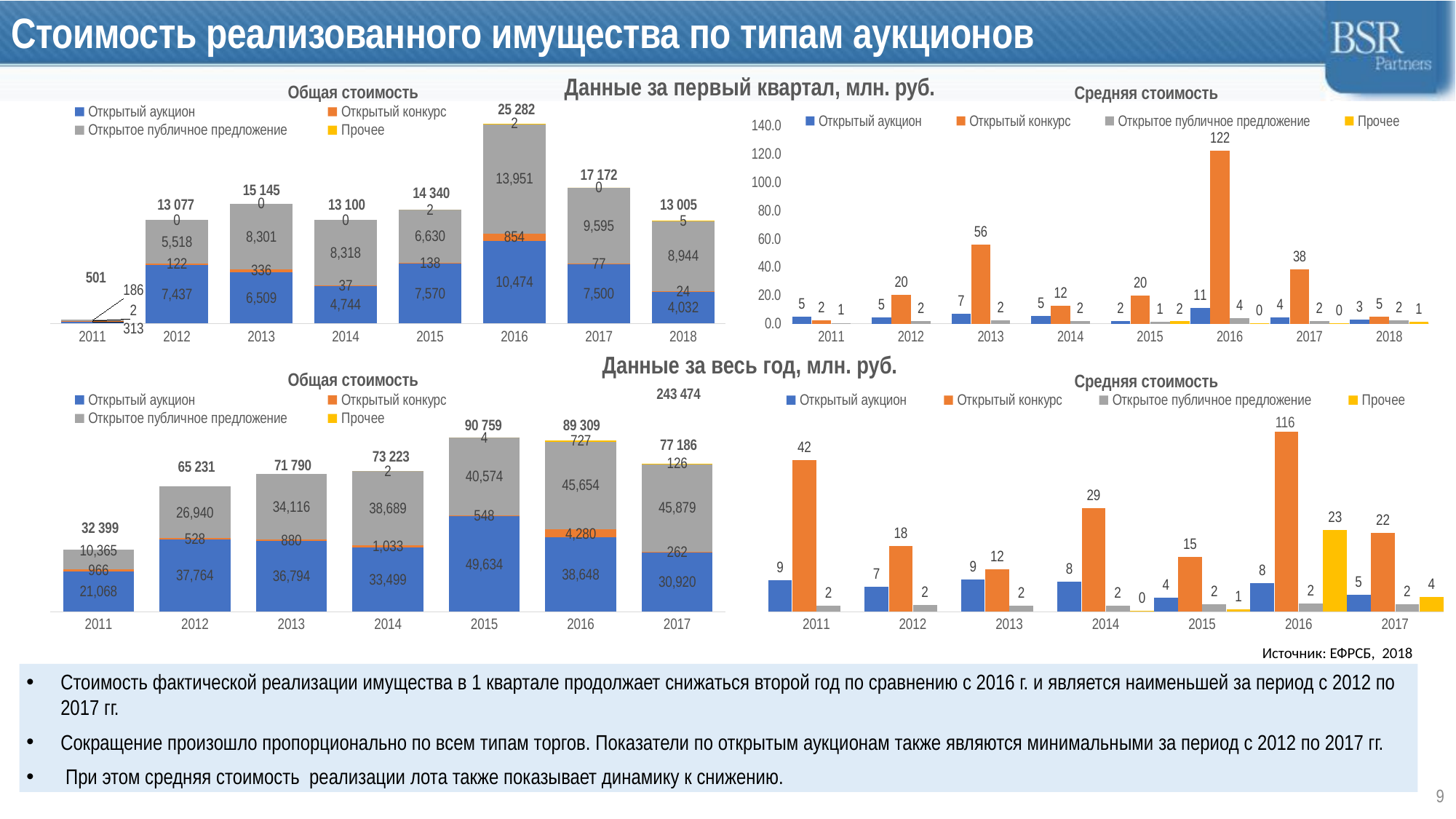
In the top-left 'Общая стоимость' chart (first quarter data), what is the total value shown above the bar for 2016? 25 282 In the bottom-left 'Общая стоимость' chart (full year data), which year has the lowest total? 2011 In the top-left 'Общая стоимость' chart (first quarter data), how many years are shown on the x axis? 8 In the top-right 'Средняя стоимость' chart (first quarter data), what is the value for 'Открытый конкурс' in 2016? 122 In the top-right 'Средняя стоимость' chart (first quarter data), is the value for 'Открытый конкурс' in 2013 greater or less than 40.0? greater In the bottom-left 'Общая стоимость' chart (full year data), what is the value of the 'Открытое публичное предложение' segment for 2017? 45,879 In the top-left 'Общая стоимость' chart (first quarter data), what is the value of the 'Открытый аукцион' segment for 2015? 7,570 In the top-left 'Общая стоимость' chart (first quarter data), what is the difference between the 'Открытый аукцион' values for 2016 and 2017? 2,974 In the top-left 'Общая стоимость' chart (first quarter data), which year has the highest total? 2016 In the bottom-right 'Средняя стоимость' chart (full year data), which is larger: the 'Открытый конкурс' value for 2011 or for 2016? 2016 How many series does the legend of the bottom-right 'Средняя стоимость' chart list? 4 In the bottom-right 'Средняя стоимость' chart (full year data), what is the value for 'Прочее' in 2016? 23